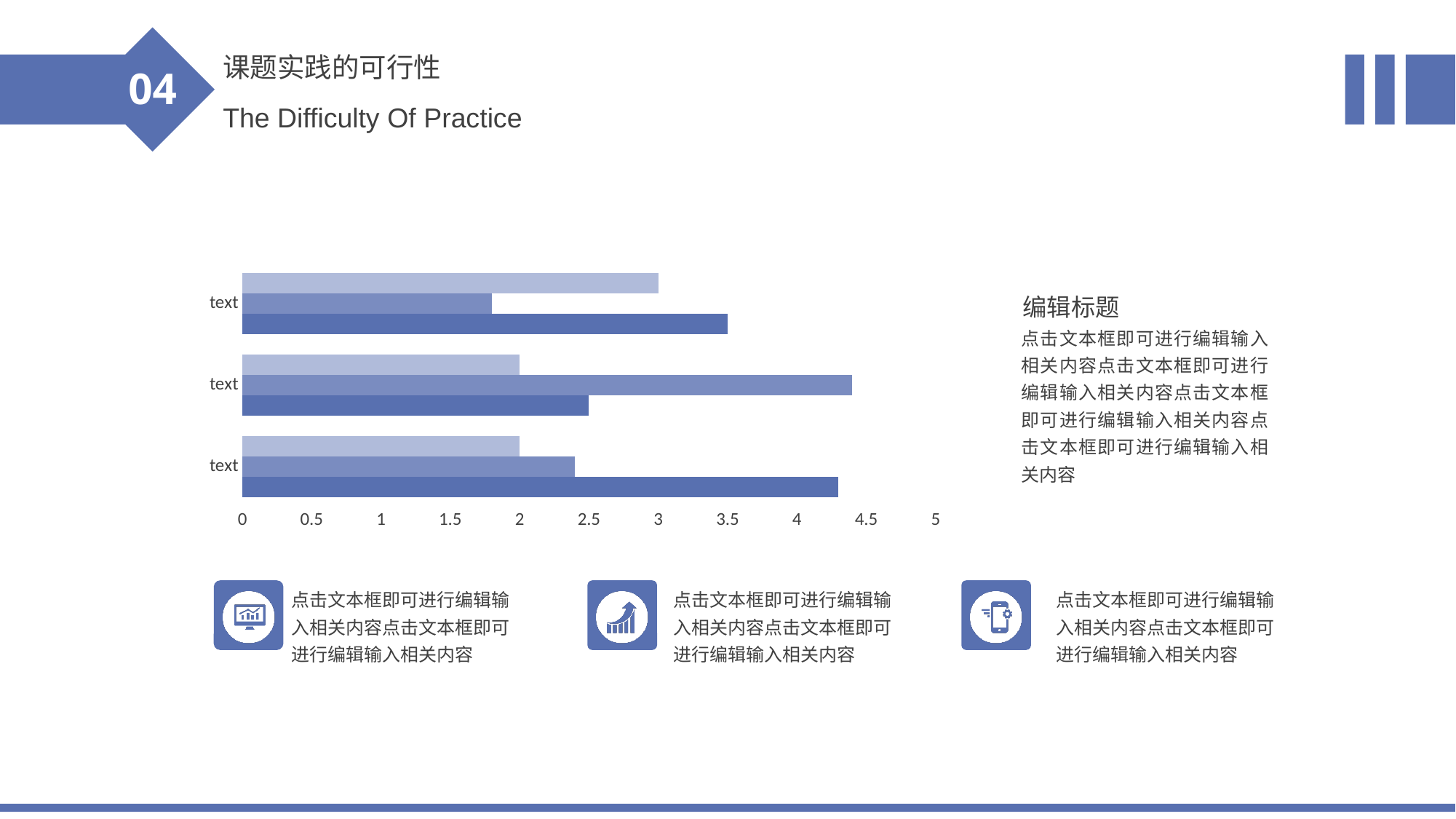
What is the highest tick value shown on the horizontal axis? 5 Which group (top, middle or bottom) has the longest medium blue bar? middle What kind of chart is shown on the slide? bar chart Is the value of the darkest blue bar in the bottom group greater or less than 4? greater Is the value of the medium blue bar in the top group greater or less than 2? less What value does the lightest blue bar in the top group reach on the axis? 3 How many category groups does the bar chart have? 3 What label is shown for each category on the vertical axis? text In the top group, which is larger: the darkest blue bar or the medium blue bar? the darkest blue bar How many bars are plotted in total on the chart? 9 Is the value of the medium blue bar in the middle group greater or less than 4? greater Which group (top, middle or bottom) has the longest darkest blue bar? bottom